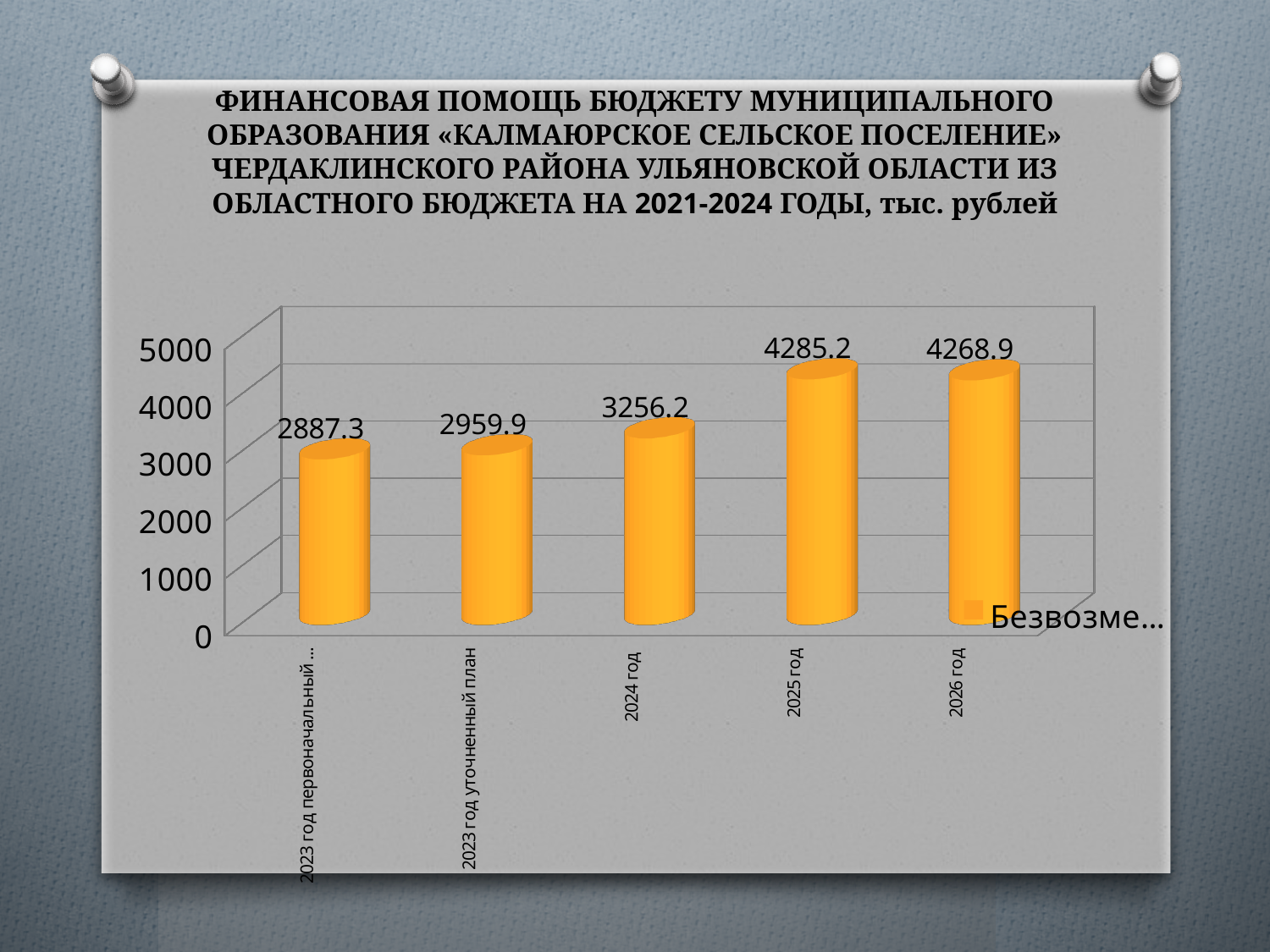
How many bars are shown in the chart? 5 Is the value for 2024 год greater or less than 3000? greater What is the difference between the values for 2025 год and 2024 год? 1029.0 Which is larger, the value for 2025 год or the value for 2026 год? 2025 год Which category has the lowest value? 2023 год первоначальный ... What is the difference between the values for 2023 год уточненный план and 2023 год первоначальный ...? 72.6 What kind of chart is shown on the slide? bar chart What is the value for 2024 год? 3256.2 Which category has the highest value? 2025 год What is the value for 2025 год? 4285.2 What is the value for 2023 год уточненный план? 2959.9 What is the value for 2026 год? 4268.9